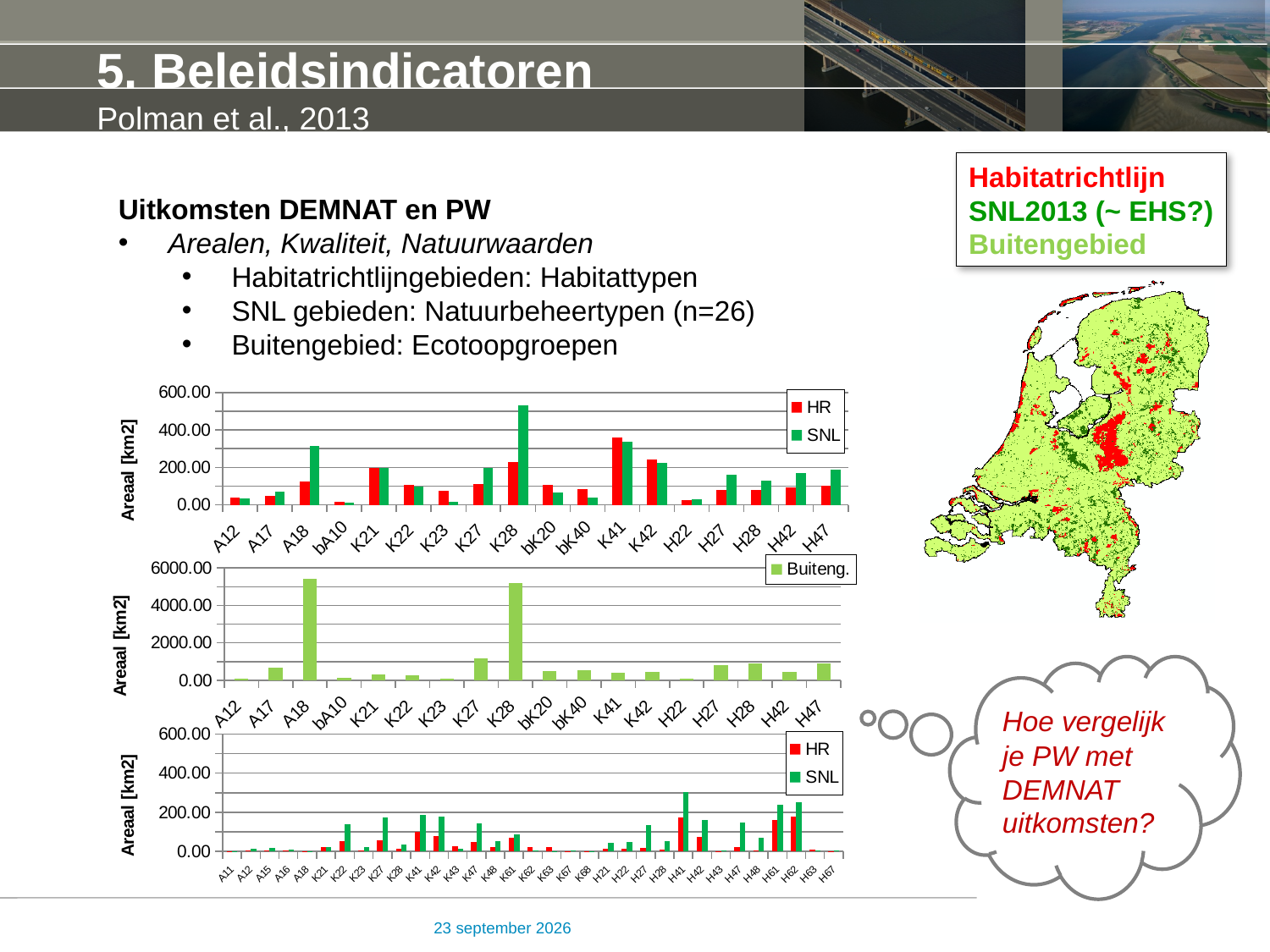
How many series does the legend of the top chart list? 2 In the top chart, which is larger for A18: the HR value or the SNL value? SNL How many series does the legend of the middle chart list? 1 In the top chart, which category has the highest SNL value? K28 In the middle chart, is the Buiteng. value for A17 greater or less than 2000.00? less What is the y-axis label of the top chart? Areaal [km2] In the top chart, is the SNL value for K28 greater or less than 400.00? greater In the bottom chart, is the SNL value for H41 greater or less than 200.00? greater How many categories are shown on the x axis of the top chart? 18 What kind of chart is the top chart on the slide? bar chart In the top chart, which category has the highest HR value? K41